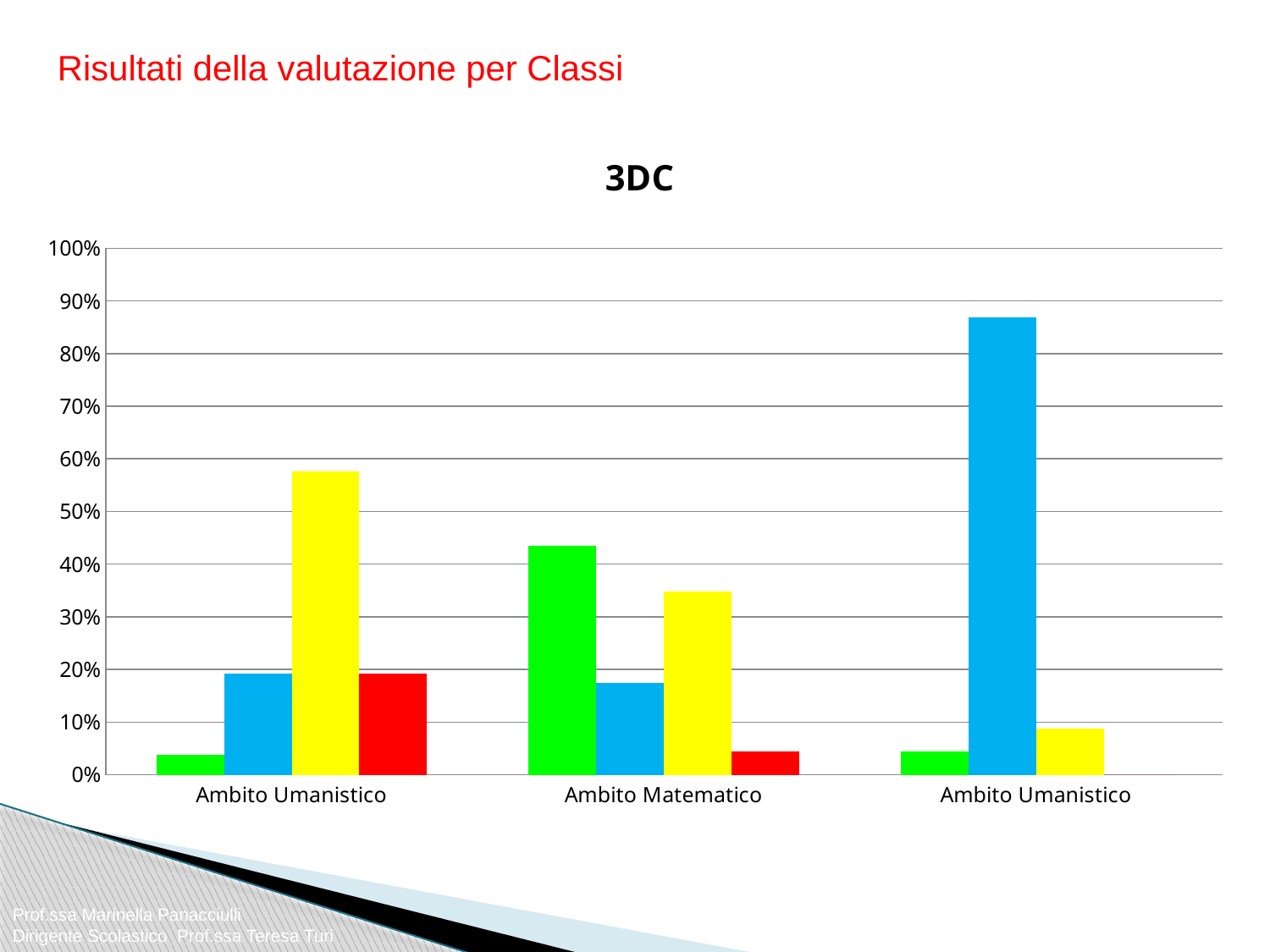
Is the value of the yellow bar in the leftmost Ambito Umanistico group greater or less than 50%? greater Which bar is the tallest in the whole chart? the blue bar in the rightmost Ambito Umanistico group Which colour bar is the tallest in the Ambito Matematico group? green Is the value of the blue bar in the rightmost Ambito Umanistico group greater or less than 80%? greater Is the value of the yellow bar in the Ambito Matematico group greater or less than 30%? greater How many different bar colours are used in the chart? 4 What kind of chart is shown on the slide? bar chart In the Ambito Matematico group, which is larger: the green bar or the yellow bar? green What is the title of the chart? 3DC How many category groups are shown along the x axis? 3